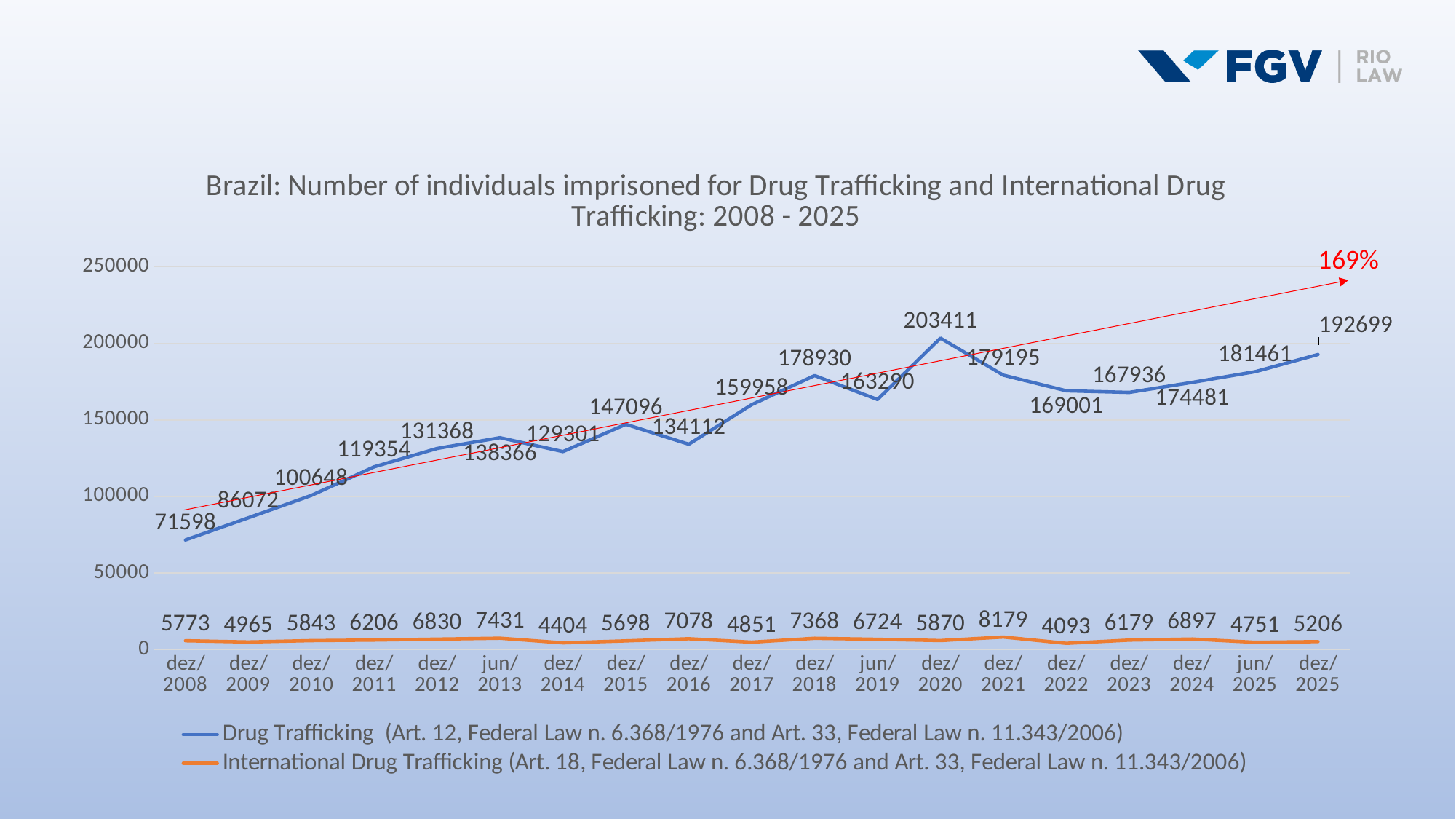
At which date does the Drug Trafficking series reach its highest value? dez/2020 How many data points are plotted along the x axis? 19 What is the difference between the Drug Trafficking values for dez/2025 and dez/2024? 18218 What is the difference between the Drug Trafficking values for dez/2020 and dez/2008? 131813 Which is larger, the International Drug Trafficking value for jun/2013 or for dez/2014? jun/2013 What kind of chart is shown on the slide? line chart Is the Drug Trafficking value for dez/2018 greater or less than 150000? greater What is the International Drug Trafficking value for dez/2021? 8179 What is the Drug Trafficking value for dez/2020? 203411 How many series does the legend list? 2 At which date is the International Drug Trafficking value lowest? dez/2022 What is the Drug Trafficking value for dez/2008? 71598